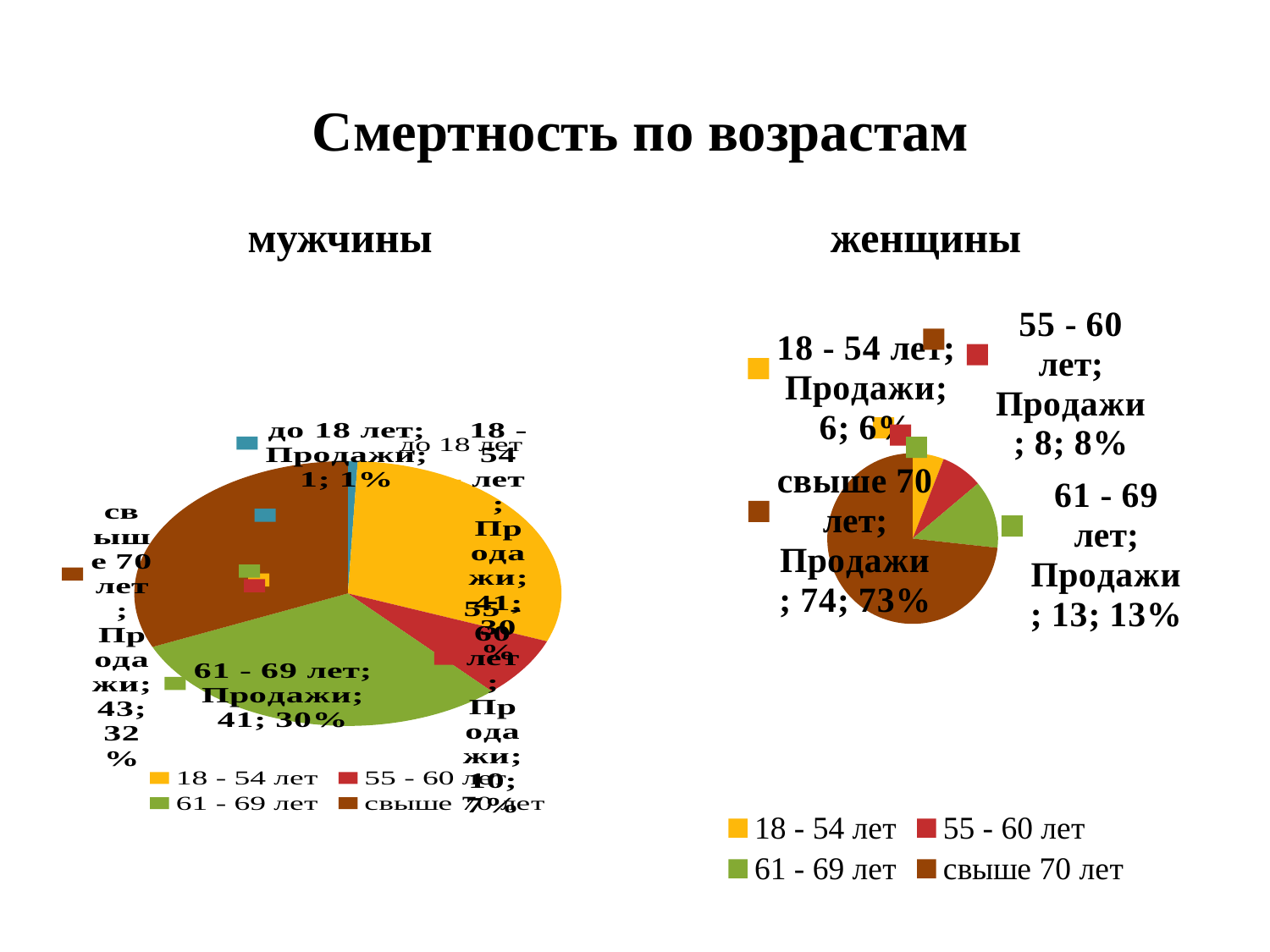
In the 'женщины' pie chart, what is the difference between the values for '61 - 69 лет' and '55 - 60 лет'? 5 In the 'мужчины' pie chart, what share does the '61 – 69 лет' slice have? 30% What kind of chart is the 'мужчины' chart? pie chart How many entries does the legend of the 'женщины' chart list? 4 In the 'женщины' pie chart, what is the value for '61 - 69 лет'? 13 In the 'женщины' pie chart, what share does the 'свыше 70 лет' slice have? 73% In the 'мужчины' pie chart, which category has the largest slice? свыше 70 лет In the 'женщины' pie chart, which category has the smallest slice? 18 - 54 лет What is the title of the slide containing the two pie charts? Смертность по возрастам In the 'женщины' pie chart, which is larger: '55 - 60 лет' or '18 - 54 лет'? 55 - 60 лет In the 'мужчины' pie chart, what is the value for 'свыше 70 лет'? 43 In the 'женщины' pie chart, which category has the largest slice? свыше 70 лет